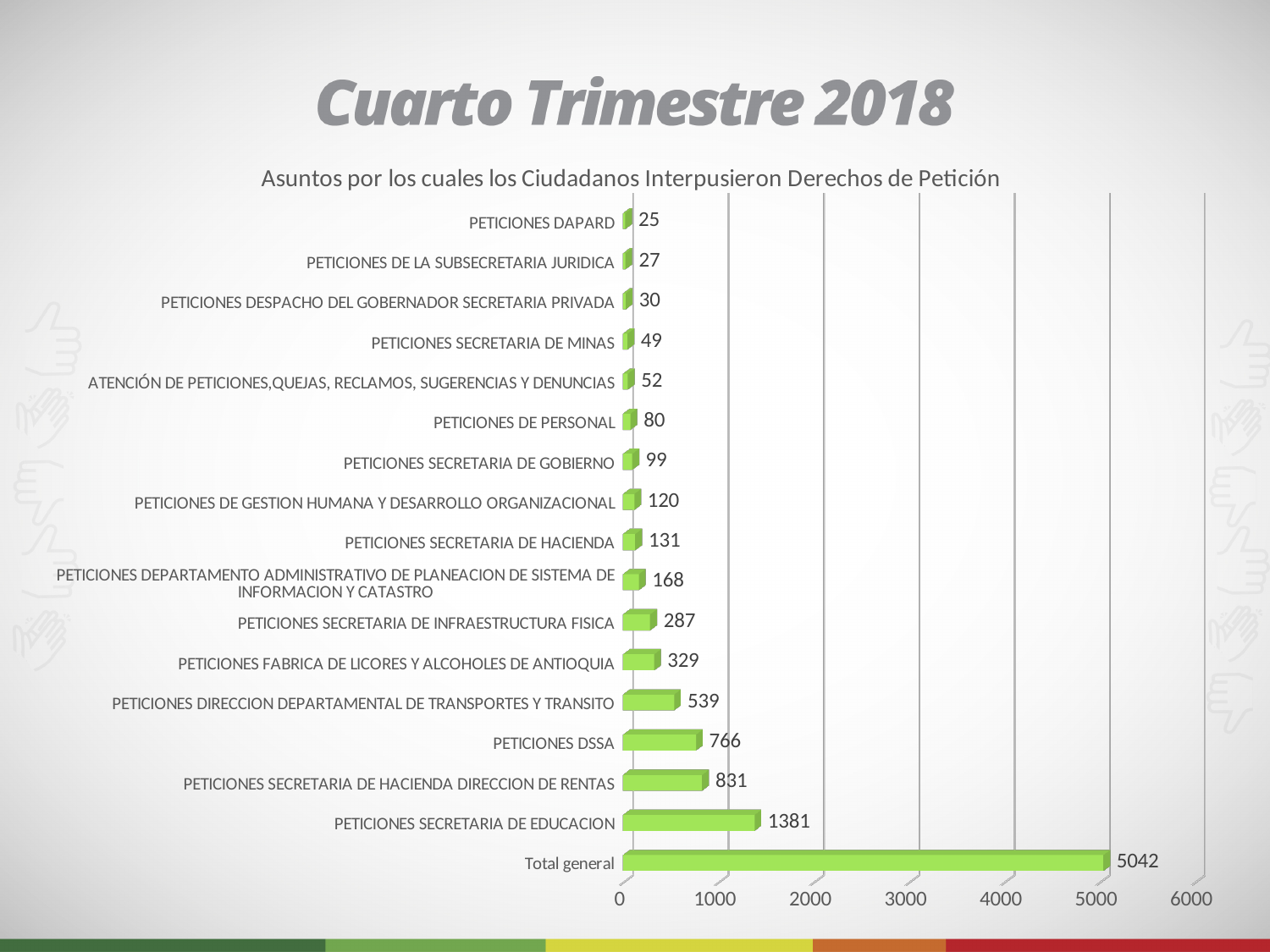
Which category has the lowest value? PETICIONES DAPARD What is the value for PETICIONES SECRETARIA DE EDUCACION? 1381 What kind of chart is shown on the slide? bar chart What is the value for PETICIONES SECRETARIA DE MINAS? 49 What is the value for PETICIONES DSSA? 766 How many categories are plotted in the chart, including Total general? 17 Which is larger: PETICIONES FABRICA DE LICORES Y ALCOHOLES DE ANTIOQUIA or PETICIONES SECRETARIA DE INFRAESTRUCTURA FISICA? PETICIONES FABRICA DE LICORES Y ALCOHOLES DE ANTIOQUIA Is the value for PETICIONES DIRECCION DEPARTAMENTAL DE TRANSPORTES Y TRANSITO greater or less than 1000? less What is the difference between PETICIONES SECRETARIA DE HACIENDA DIRECCION DE RENTAS and PETICIONES DSSA? 65 Excluding Total general, which category has the highest value? PETICIONES SECRETARIA DE EDUCACION What is the value shown for Total general? 5042 What is the title of the chart? Asuntos por los cuales los Ciudadanos Interpusieron Derechos de Petición